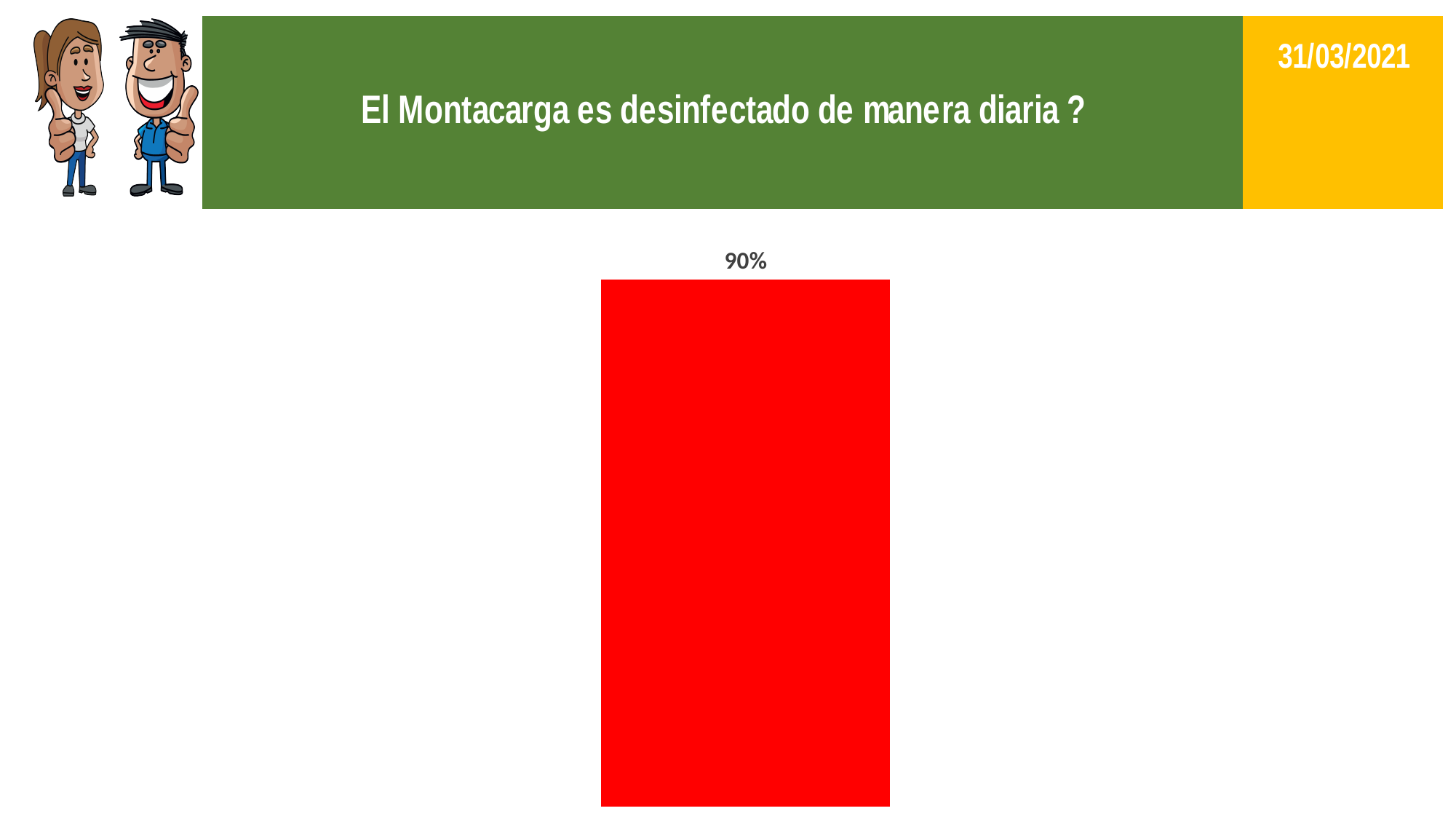
How many bars does the chart contain? 1 What value is printed above the single bar in the chart? 90% What colour is the bar in the chart? red What kind of chart is shown on the slide? bar chart What question is written in the green header above the chart? El Montacarga es desinfectado de manera diaria ?